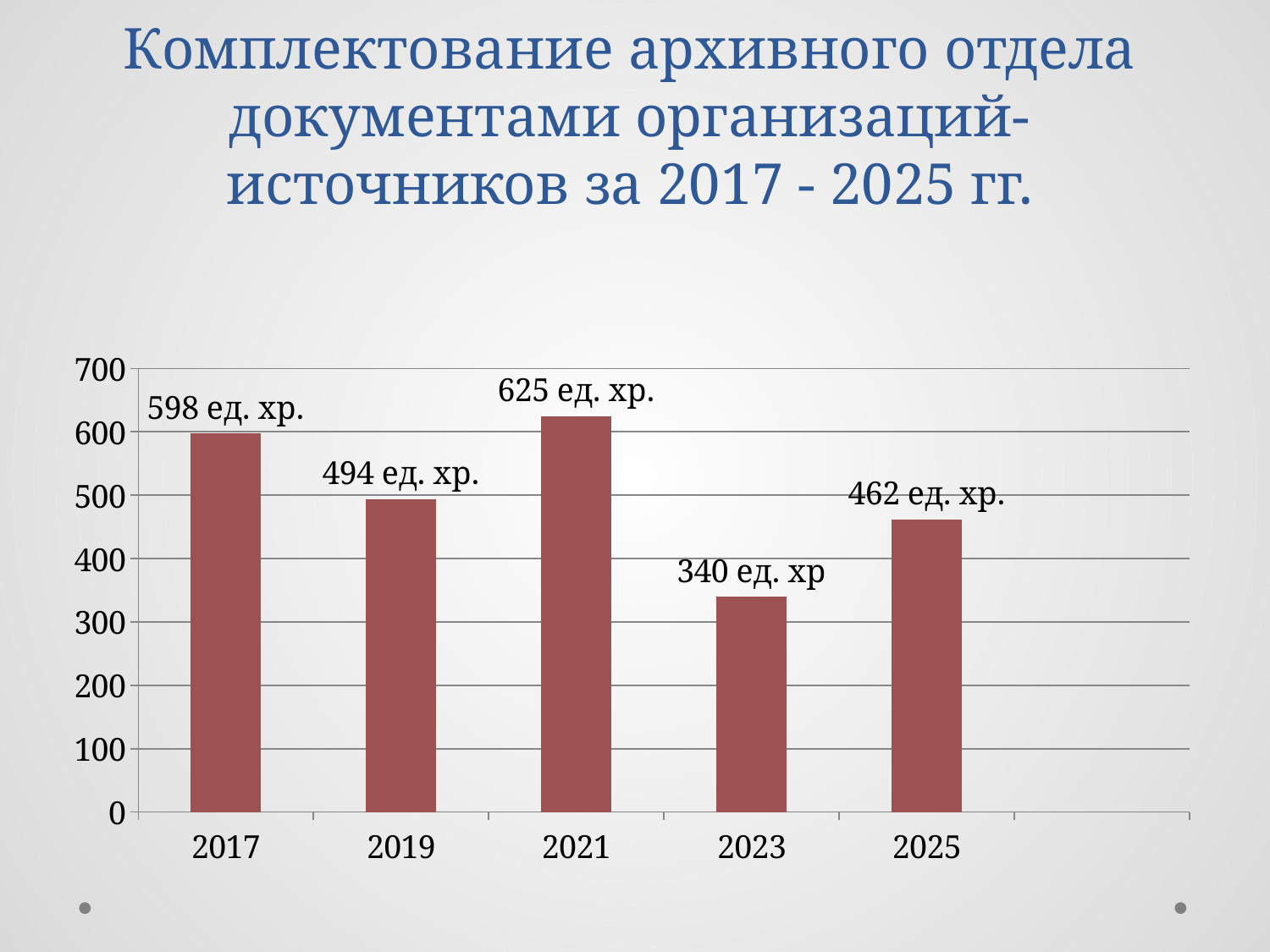
Which year has the lowest value? 2023 Which year has the highest value? 2021 What is the difference between the values for 2021 and 2023? 285 Is the value for 2021 greater or less than 600? greater How many years are shown on the x axis? 5 What value is shown for 2023? 340 ед. хр Which is larger, the value for 2019 or the value for 2025? 2019 What value is shown for 2025? 462 ед. хр. What kind of chart is shown on the slide? bar chart What value is shown for 2017? 598 ед. хр. What is the title of the slide? Комплектование архивного отдела документами организаций-источников за 2017 - 2025 гг. What is the difference between the values for 2017 and 2019? 104